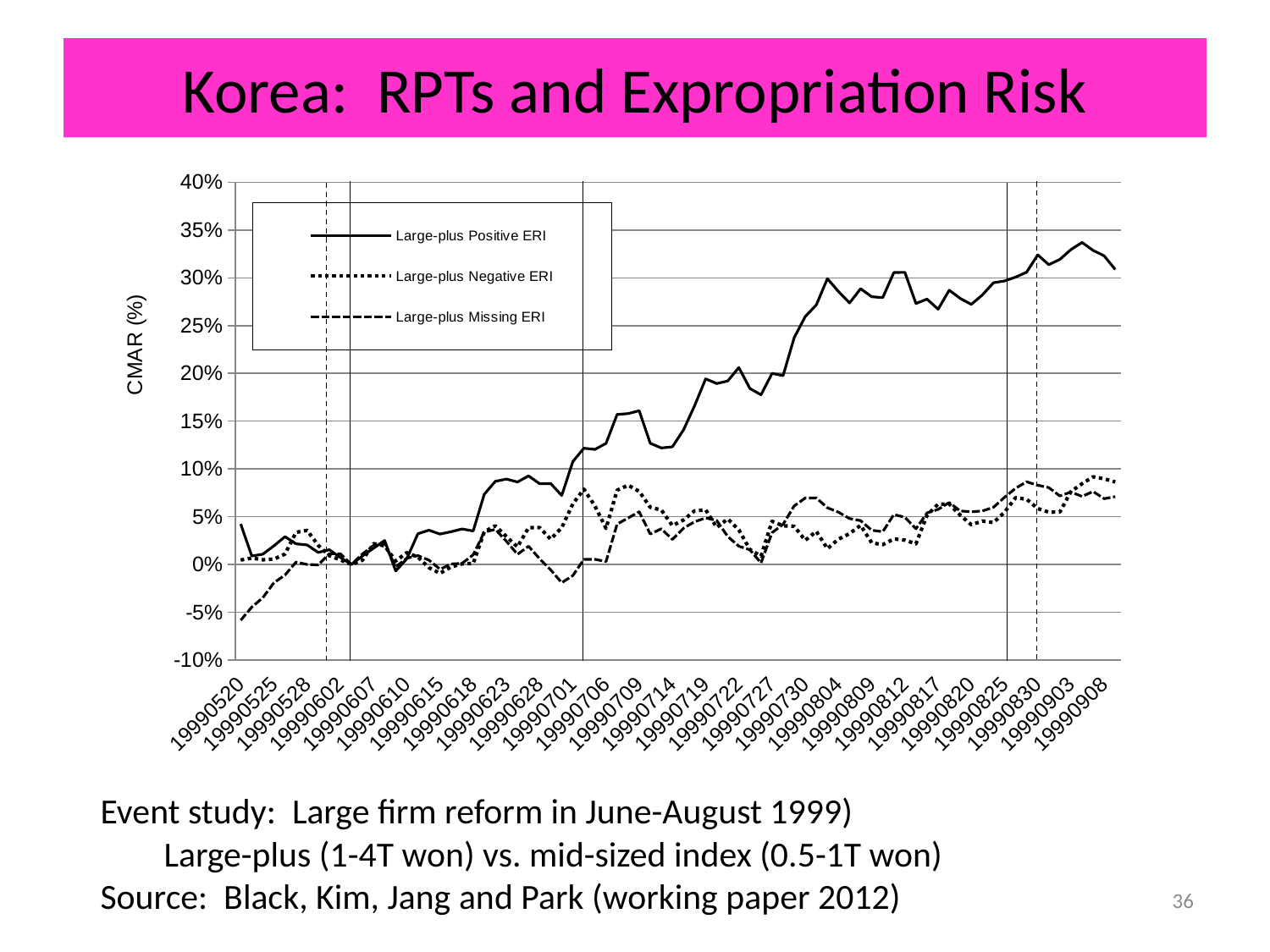
Which series reaches the highest value on the chart? Large-plus Positive ERI Is the value for Large-plus Negative ERI at 19990908 greater or less than 20%? less Which series is drawn with a solid line according to the legend? Large-plus Positive ERI At 19990520, which series has the larger value: Large-plus Positive ERI or Large-plus Missing ERI? Large-plus Positive ERI What is the label on the vertical axis of the chart? CMAR (%) At 19990908, which series has the larger value: Large-plus Positive ERI or Large-plus Negative ERI? Large-plus Positive ERI Does the Large-plus Positive ERI series generally rise or fall from 19990520 to 19990908? rise What kind of chart is shown on the slide? line chart Is the value for Large-plus Positive ERI at 19990903 greater or less than 30%? greater Is the value for Large-plus Missing ERI at 19990520 greater or less than 0%? less How many series does the chart's legend list? 3